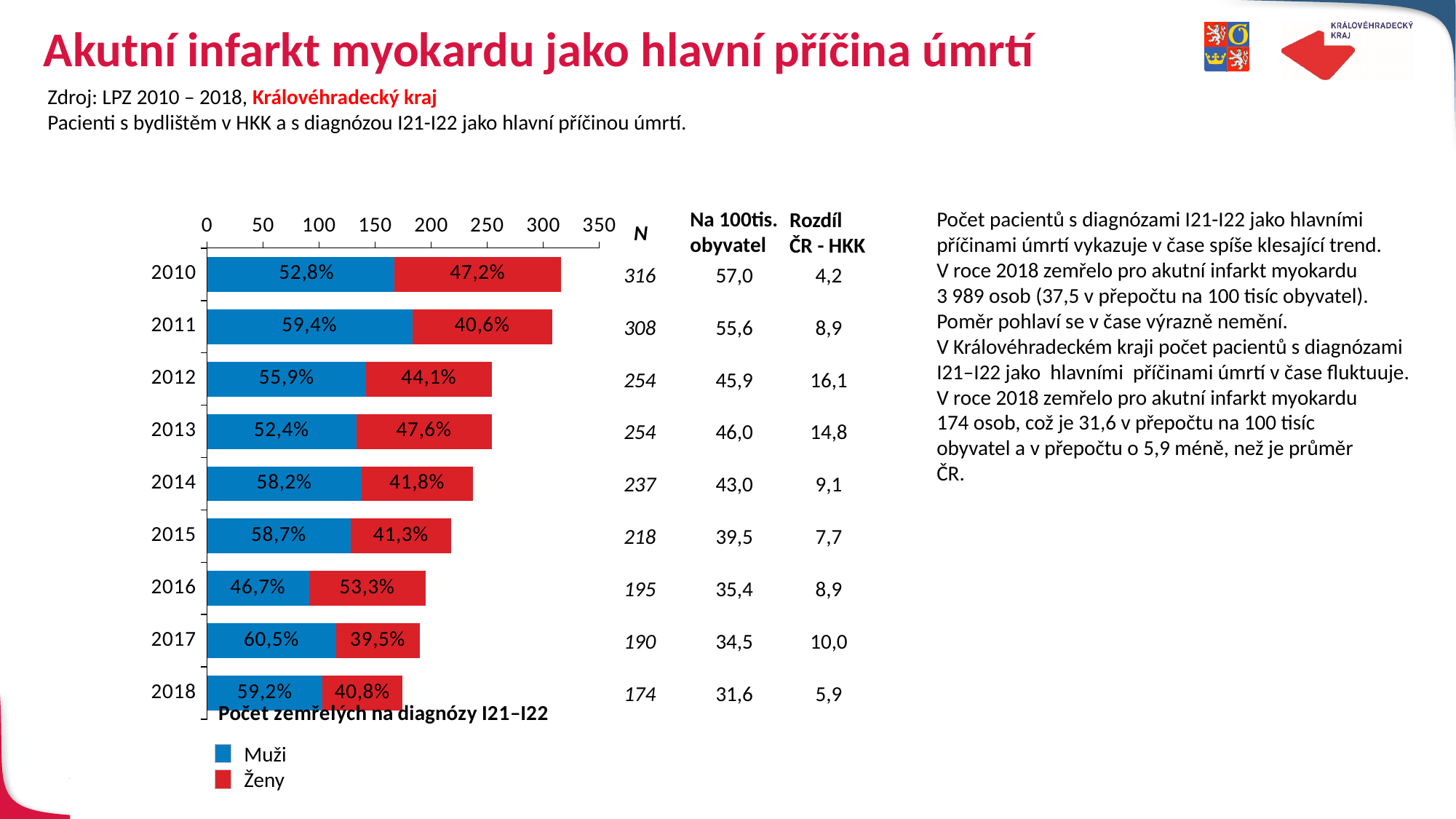
What percentage share do men (Muži) have in the 2010 bar? 52,8% Which year has the shortest bar (lowest total number of deaths)? 2018 Do the total bar lengths generally rise or fall from 2010 to 2018? Fall Which year has the longest bar (highest total number of deaths)? 2010 Is the total bar length for 2018 greater or less than 200? less How many years (categories) are shown in the chart? 9 In 2016, which share is larger, men (Muži) or women (Ženy)? Ženy What type of chart is shown on the slide? Stacked bar chart Is the total bar length for 2010 greater or less than 300? greater How many series does the legend list? 2 What is the men's (Muži) share shown for 2017? 60,5% What percentage share do women (Ženy) have in the 2016 bar? 53,3%